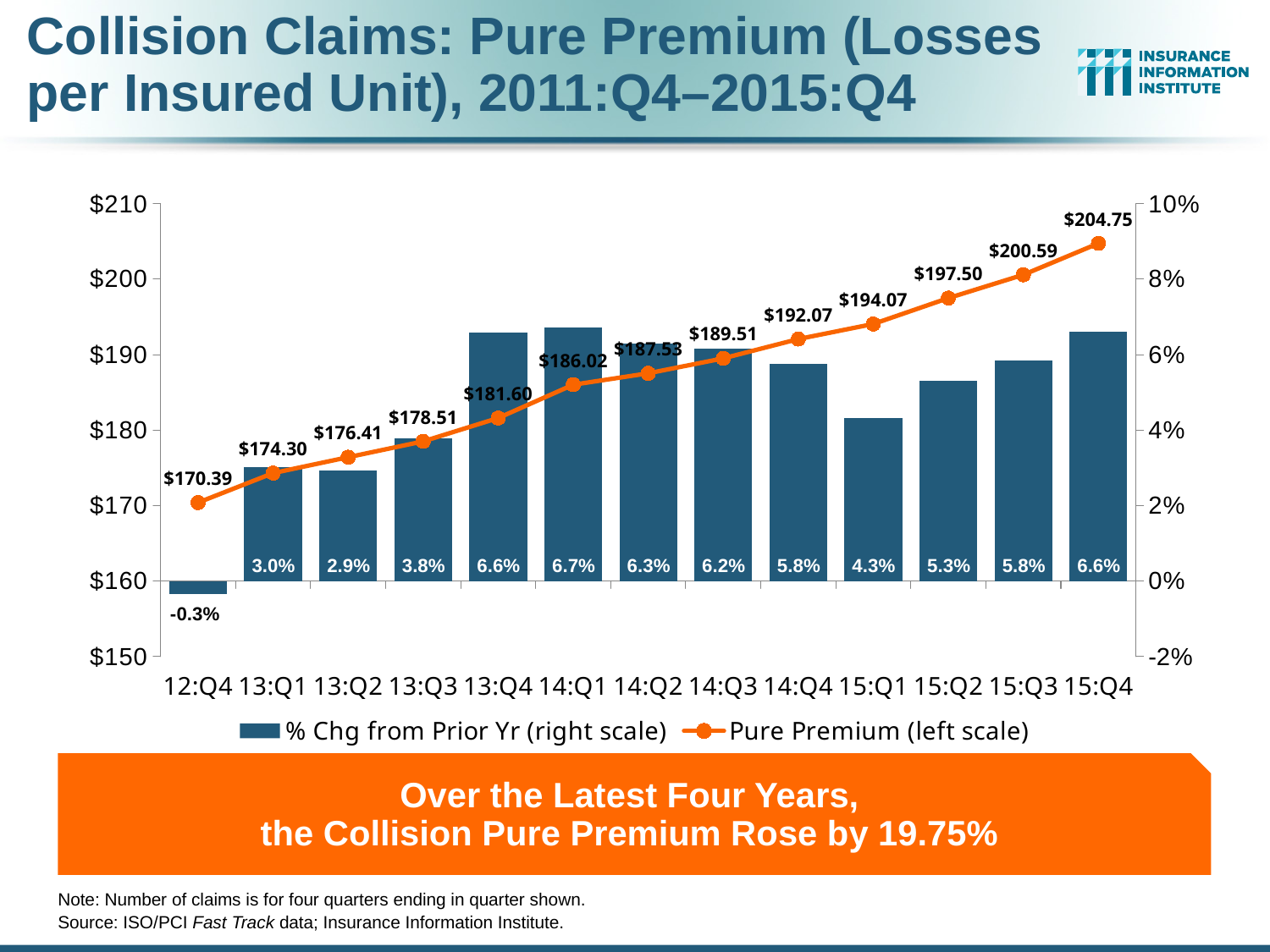
What is the Pure Premium value for 14:Q2? $187.53 How many series does the legend list? 2 What is the Pure Premium value for 12:Q4? $170.39 What is the difference in Pure Premium between 15:Q4 and 12:Q4? $34.36 What kind of chart is this? Combined bar and line chart Which quarter has the lowest % Chg from Prior Yr? 12:Q4 Which series is plotted on the right scale according to the legend? % Chg from Prior Yr Which quarter has the highest Pure Premium? 15:Q4 Does the Pure Premium rise or fall from 12:Q4 to 15:Q4? Rise Which is larger, the % Chg from Prior Yr for 13:Q4 or for 14:Q4? 13:Q4 What is the % Chg from Prior Yr for 15:Q1? 4.3% How many quarters are shown on the x axis? 13